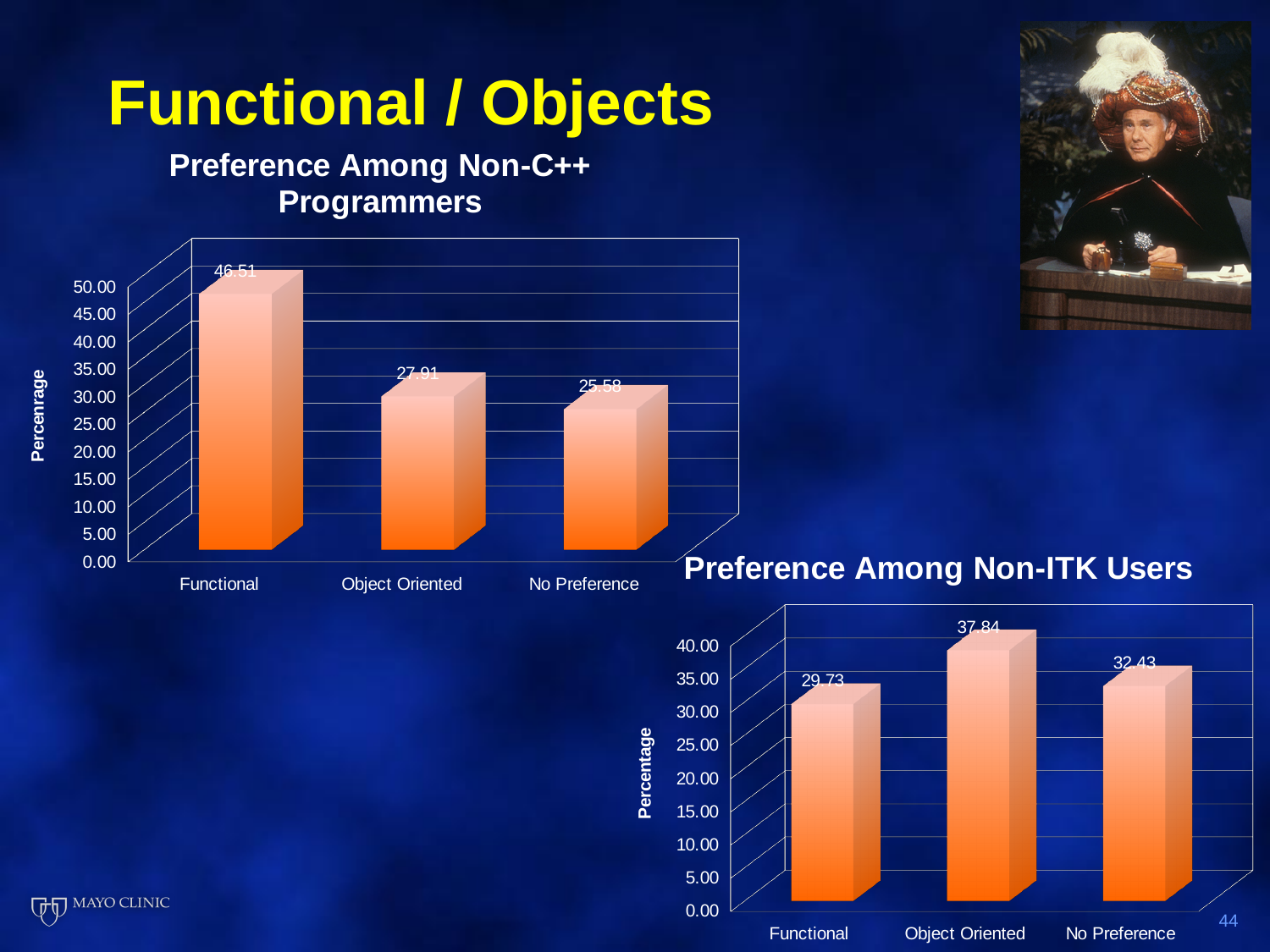
In the 'Preference Among Non-C++ Programmers' chart, what is the difference between the Functional and Object Oriented values? 18.60 In the 'Preference Among Non-ITK Users' chart, what is the value for No Preference? 32.43 How many categories are shown in the 'Preference Among Non-ITK Users' chart? 3 In the 'Preference Among Non-C++ Programmers' chart, what is the value for Object Oriented? 27.91 In the 'Preference Among Non-ITK Users' chart, what is the value for Object Oriented? 37.84 In the 'Preference Among Non-C++ Programmers' chart, which category has the highest value? Functional In the 'Preference Among Non-ITK Users' chart, which category has the lowest value? Functional In the 'Preference Among Non-ITK Users' chart, which category has the highest value? Object Oriented In the 'Preference Among Non-C++ Programmers' chart, what is the value for Functional? 46.51 In the 'Preference Among Non-C++ Programmers' chart, which category has the lowest value? No Preference What type of chart is the 'Preference Among Non-C++ Programmers' chart? Bar chart In the 'Preference Among Non-ITK Users' chart, which is larger, the value for Functional or the value for No Preference? No Preference